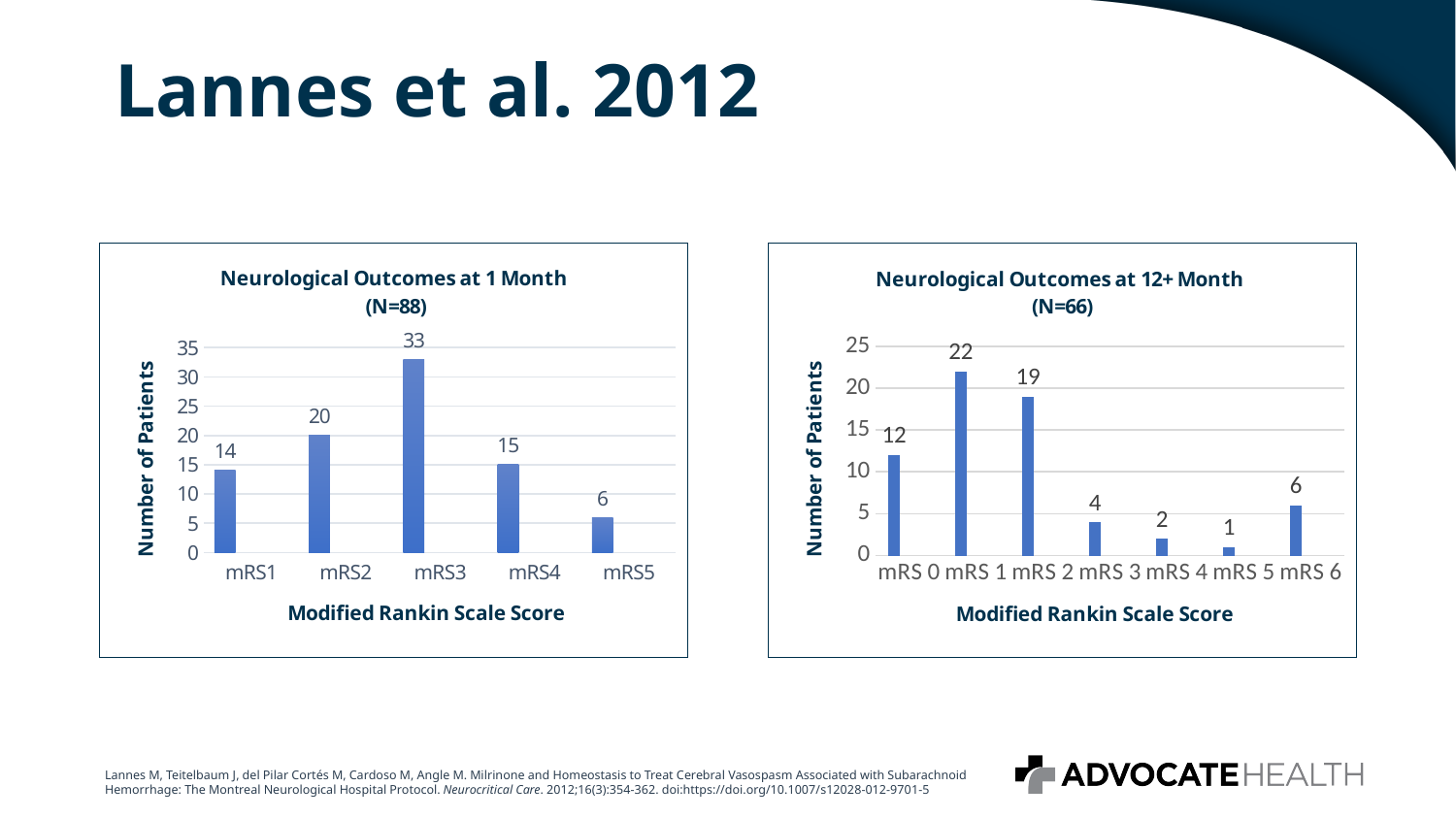
In the 'Neurological Outcomes at 1 Month (N=88)' chart, how many Modified Rankin Scale score categories are shown? 5 In the 'Neurological Outcomes at 1 Month (N=88)' chart, is the value for mRS1 greater or less than 15? less In the 'Neurological Outcomes at 1 Month (N=88)' chart, which Modified Rankin Scale score has the fewest patients? mRS5 In the 'Neurological Outcomes at 12+ Month (N=66)' chart, which Modified Rankin Scale score has the fewest patients? mRS 5 In the 'Neurological Outcomes at 1 Month (N=88)' chart, what is the difference between the number of patients at mRS2 and at mRS4? 5 In the 'Neurological Outcomes at 1 Month (N=88)' chart, how many patients had a score of mRS3? 33 In the 'Neurological Outcomes at 12+ Month (N=66)' chart, which has more patients, mRS 0 or mRS 6? mRS 0 In the 'Neurological Outcomes at 12+ Month (N=66)' chart, how many Modified Rankin Scale score categories are shown? 7 In the 'Neurological Outcomes at 12+ Month (N=66)' chart, how many patients had a score of mRS 1? 22 What type of chart is the 'Neurological Outcomes at 12+ Month (N=66)' chart? Bar chart What is the y-axis label of the 'Neurological Outcomes at 1 Month (N=88)' chart? Number of Patients In the 'Neurological Outcomes at 12+ Month (N=66)' chart, which Modified Rankin Scale score has the most patients? mRS 1